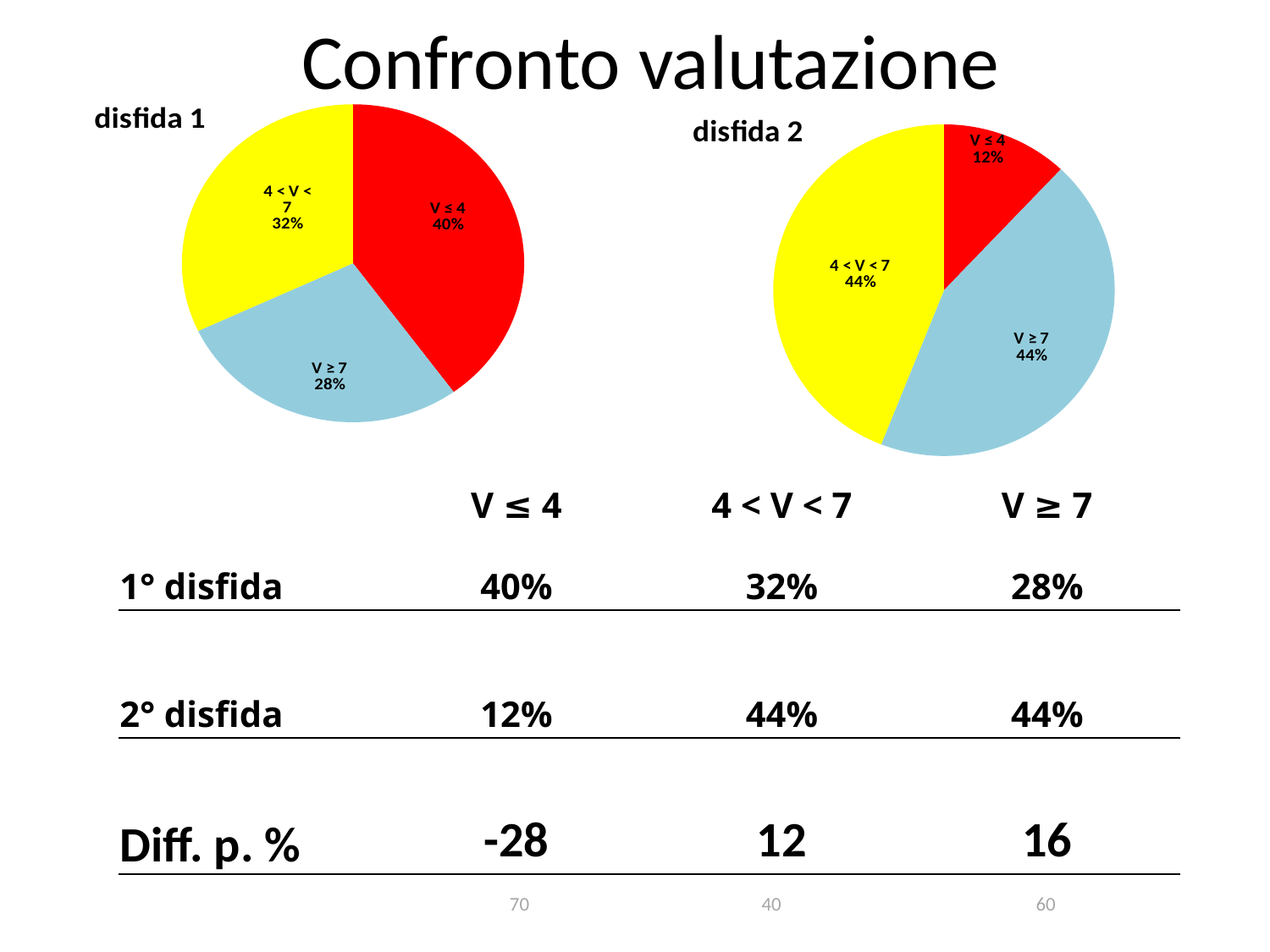
In the 'disfida 2' pie chart, which slice is the smallest? V ≤ 4 In the 'disfida 1' pie chart, which is larger: the '4 < V < 7' slice or the 'V ≥ 7' slice? 4 < V < 7 In the 'disfida 1' pie chart, which slice is the largest? V ≤ 4 In the 'disfida 2' pie chart, what share does the '4 < V < 7' slice have? 44% In the 'disfida 1' pie chart, what share does the 'V ≤ 4' slice have? 40% In the 'disfida 1' pie chart, what is the difference between the 'V ≤ 4' share and the '4 < V < 7' share? 8% What type of chart is used for 'disfida 1'? Pie chart In the 'disfida 1' pie chart, what share does the 'V ≥ 7' slice have? 28% In the 'disfida 2' pie chart, what is the difference between the 'V ≥ 7' share and the 'V ≤ 4' share? 32% How many slices does the 'disfida 2' pie chart have? 3 In the 'disfida 1' pie chart, which slice is the smallest? V ≥ 7